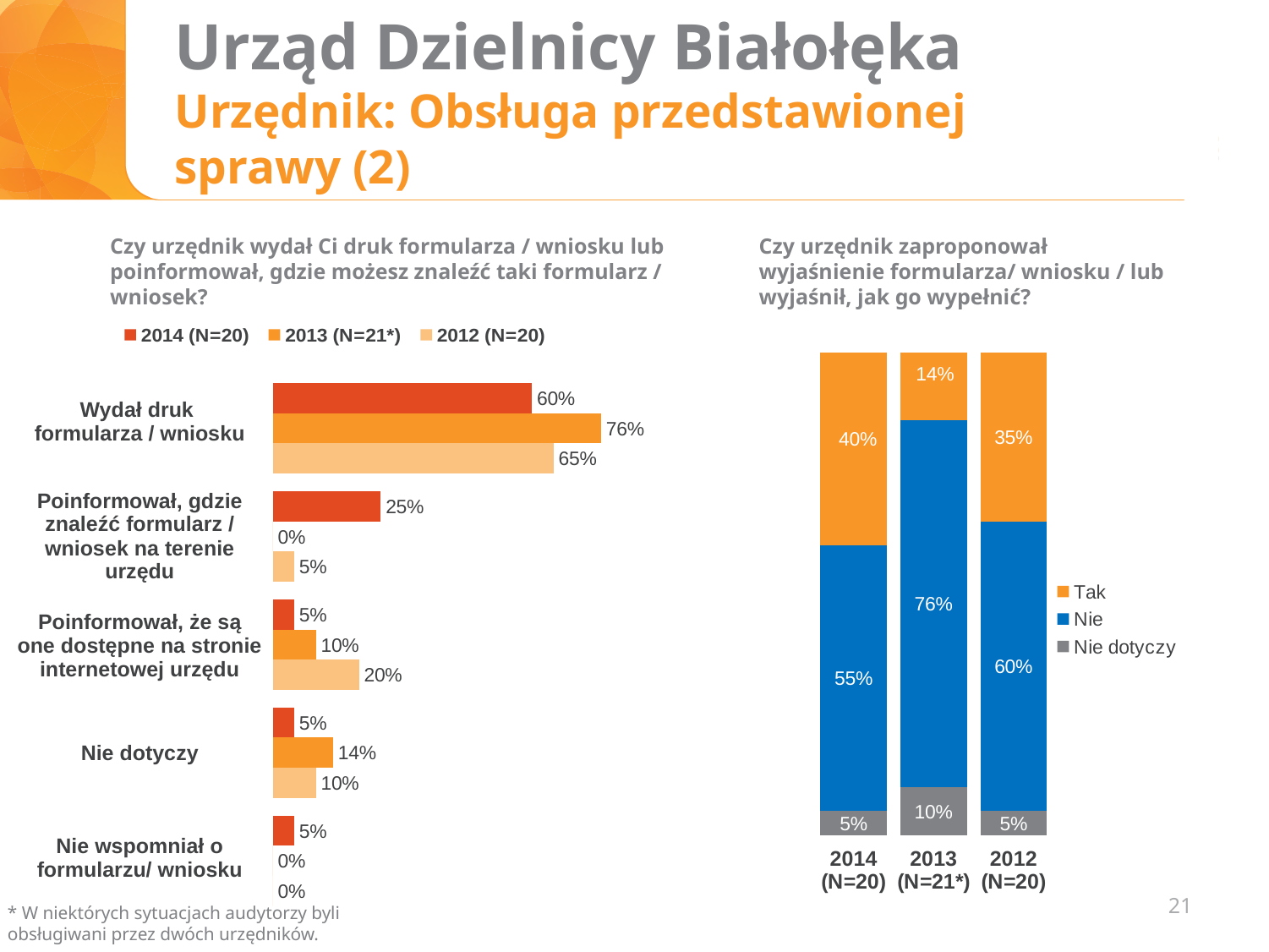
In the left chart, how many categories are shown? 5 In the left chart, what is the value for 2012 (N=20) for 'Poinformował, że są one dostępne na stronie internetowej urzędu'? 20% In the right chart, what is the 'Nie' share for 2013 (N=21*)? 76% In the left chart, which year has the highest value for 'Wydał druk formularza / wniosku'? 2013 (N=21*) In the left chart, how many series does the legend list? 3 In the left chart, what is the value for 2013 (N=21*) for 'Wydał druk formularza / wniosku'? 76% What kind of chart is the chart on the right? Stacked bar chart In the right chart, which year has the lowest 'Tak' share? 2013 (N=21*) In the left chart, what is the value for 2014 (N=20) for 'Poinformował, gdzie znaleźć formularz / wniosek na terenie urzędu'? 25% In the left chart, what is the difference between the 2013 and 2014 values for 'Wydał druk formularza / wniosku'? 16% In the right chart, is the 'Nie' share for 2014 (N=20) larger or smaller than the 'Nie' share for 2012 (N=20)? Smaller In the right chart, what is the 'Tak' share for 2012 (N=20)? 35%